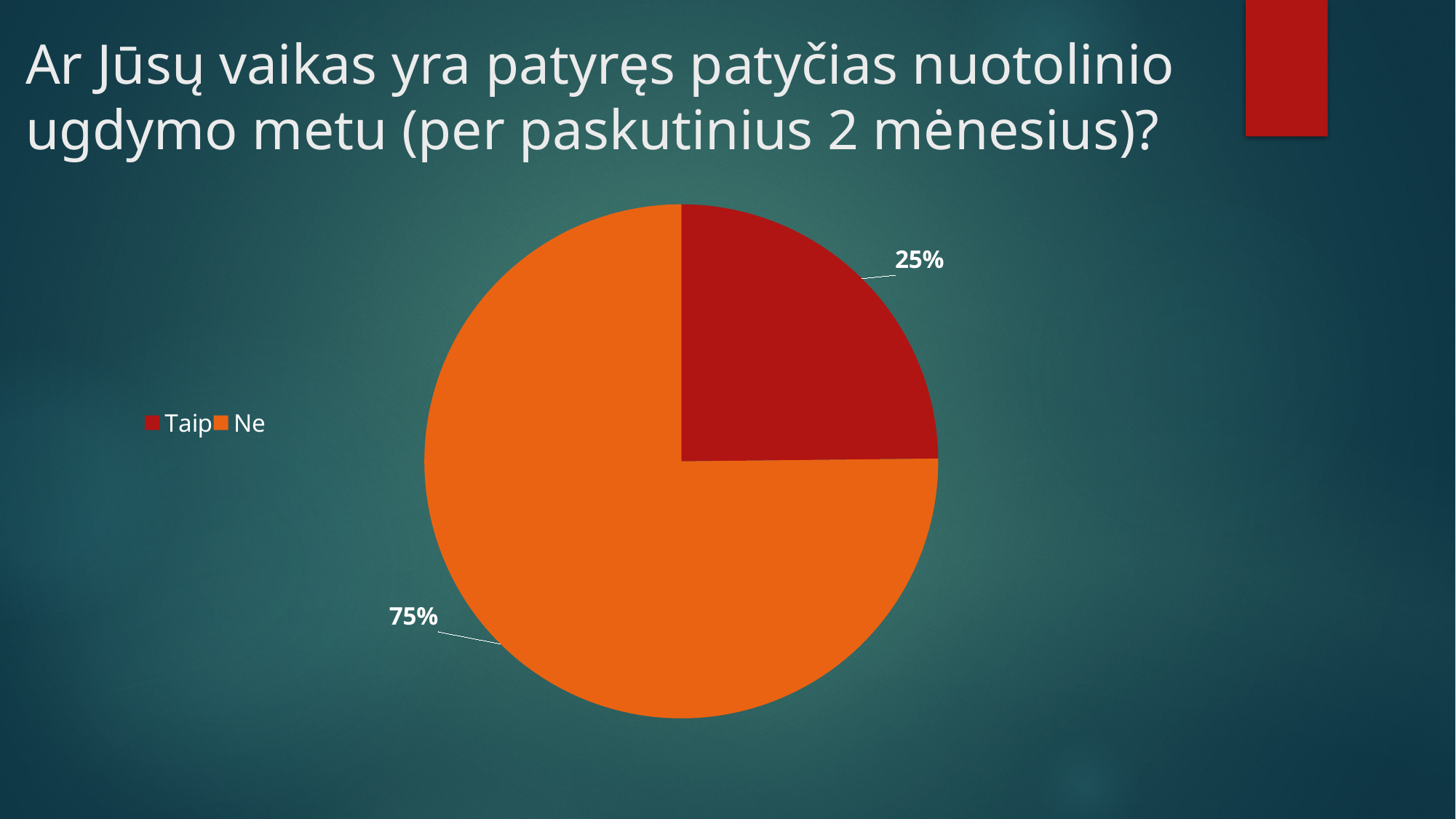
What colour is the "Taip" slice? dark red How many categories does the pie chart have? 2 What colour is the "Ne" slice? orange Which category has the smallest slice of the pie? Taip Which category has the largest slice of the pie? Ne What share of the pie does the "Ne" slice represent? 75% What kind of chart is shown on the slide? pie chart What is the difference in percentage points between the "Ne" and "Taip" slices? 50 How many entries does the legend list? 2 What share of the pie does the "Taip" slice represent? 25% Which is larger, the "Taip" slice or the "Ne" slice? Ne